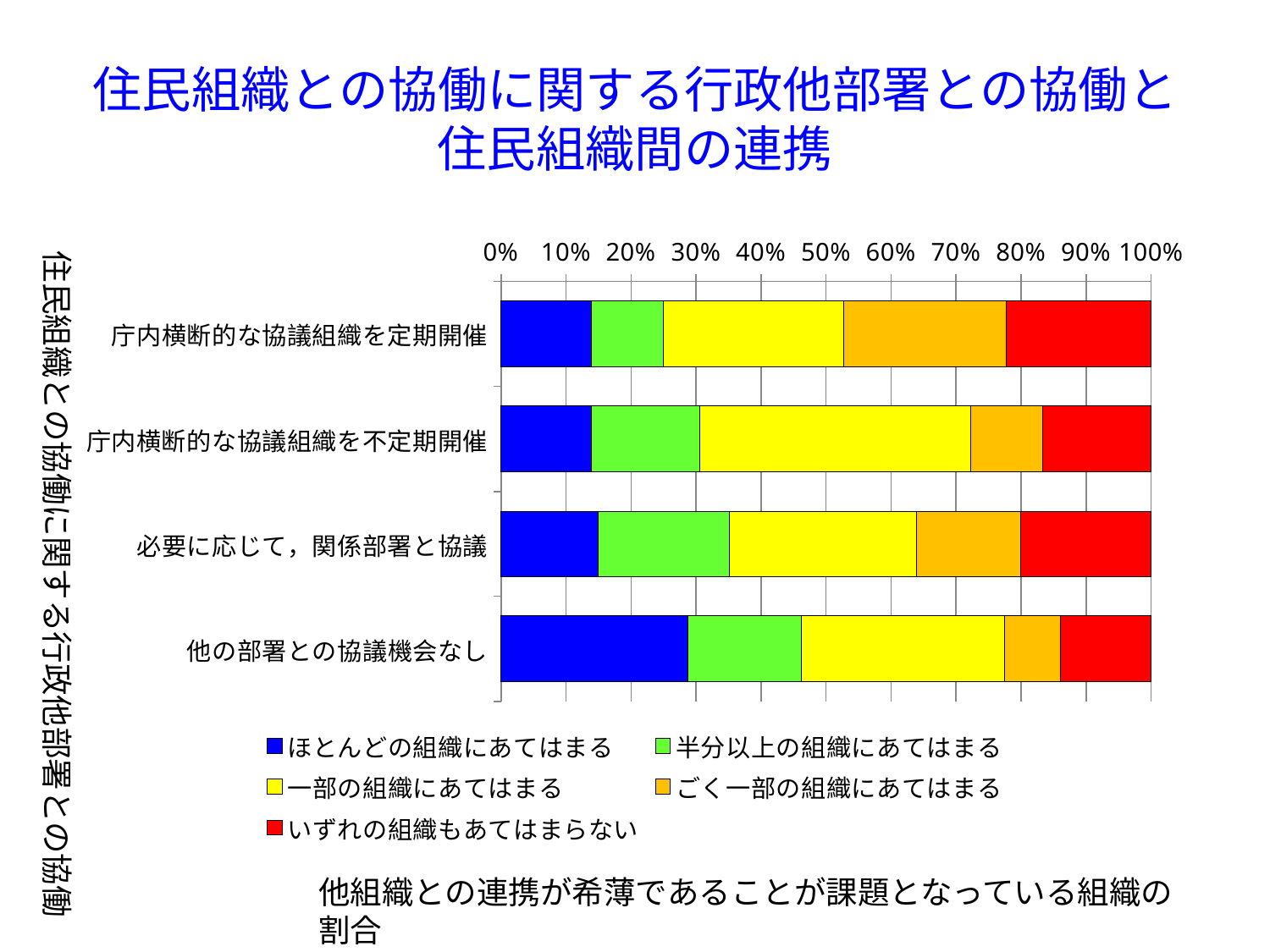
Which category has the largest 「ほとんどの組織にあてはまる」 (blue) segment? 他の部署との協議機会なし Which legend entry is shown in red? いずれの組織もあてはまらない What kind of chart is shown on the slide? stacked bar chart Is the 「ほとんどの組織にあてはまる」 share for 他の部署との協議機会なし greater or less than 20%? greater What is the total of each stacked bar in the chart? 100% Is the 「ほとんどの組織にあてはまる」 share for 庁内横断的な協議組織を定期開催 greater or less than 20%? less Which has the larger 「一部の組織にあてはまる」 (yellow) segment: 庁内横断的な協議組織を定期開催 or 庁内横断的な協議組織を不定期開催? 庁内横断的な協議組織を不定期開催 How many series does the chart's legend list? 5 Is the 「半分以上の組織にあてはまる」 share for 他の部署との協議機会なし greater or less than 10%? greater How many categories are plotted on the vertical axis of the chart? 4 Which category has the largest 「ごく一部の組織にあてはまる」 (orange) segment? 庁内横断的な協議組織を定期開催 Which has the larger 「ごく一部の組織にあてはまる」 (orange) segment: 庁内横断的な協議組織を定期開催 or 他の部署との協議機会なし? 庁内横断的な協議組織を定期開催